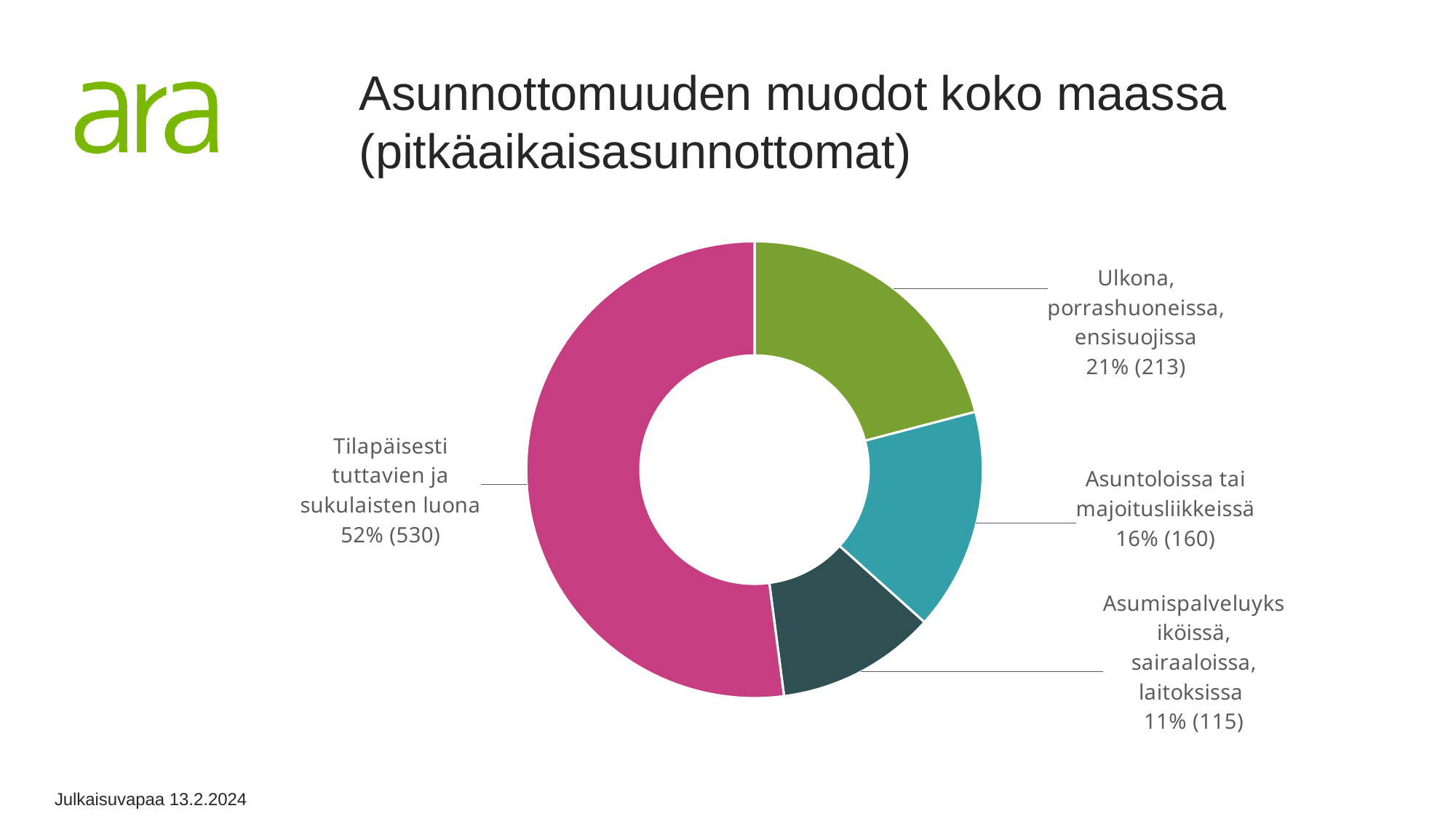
What percentage is shown for 'Asumispalveluyksiköissä, sairaaloissa, laitoksissa'? 11% Which category has the smallest share? Asumispalveluyksiköissä, sairaaloissa, laitoksissa What is the count shown for 'Asuntoloissa tai majoitusliikkeissä'? 160 How many categories does the chart show? 4 Which category has the largest share? Tilapäisesti tuttavien ja sukulaisten luona Which is larger: the count for 'Asuntoloissa tai majoitusliikkeissä' or for 'Asumispalveluyksiköissä, sairaaloissa, laitoksissa'? Asuntoloissa tai majoitusliikkeissä What share of the chart is 'Tilapäisesti tuttavien ja sukulaisten luona'? 52% What is the difference in count between 'Ulkona, porrashuoneissa, ensisuojissa' and 'Asuntoloissa tai majoitusliikkeissä'? 53 What kind of chart is shown on the slide? Doughnut (pie) chart What is the title of the chart on the slide? Asunnottomuuden muodot koko maassa (pitkäaikaisasunnottomat) What colour is the slice for 'Tilapäisesti tuttavien ja sukulaisten luona'? Pink (magenta) What is the count shown for 'Ulkona, porrashuoneissa, ensisuojissa'? 213